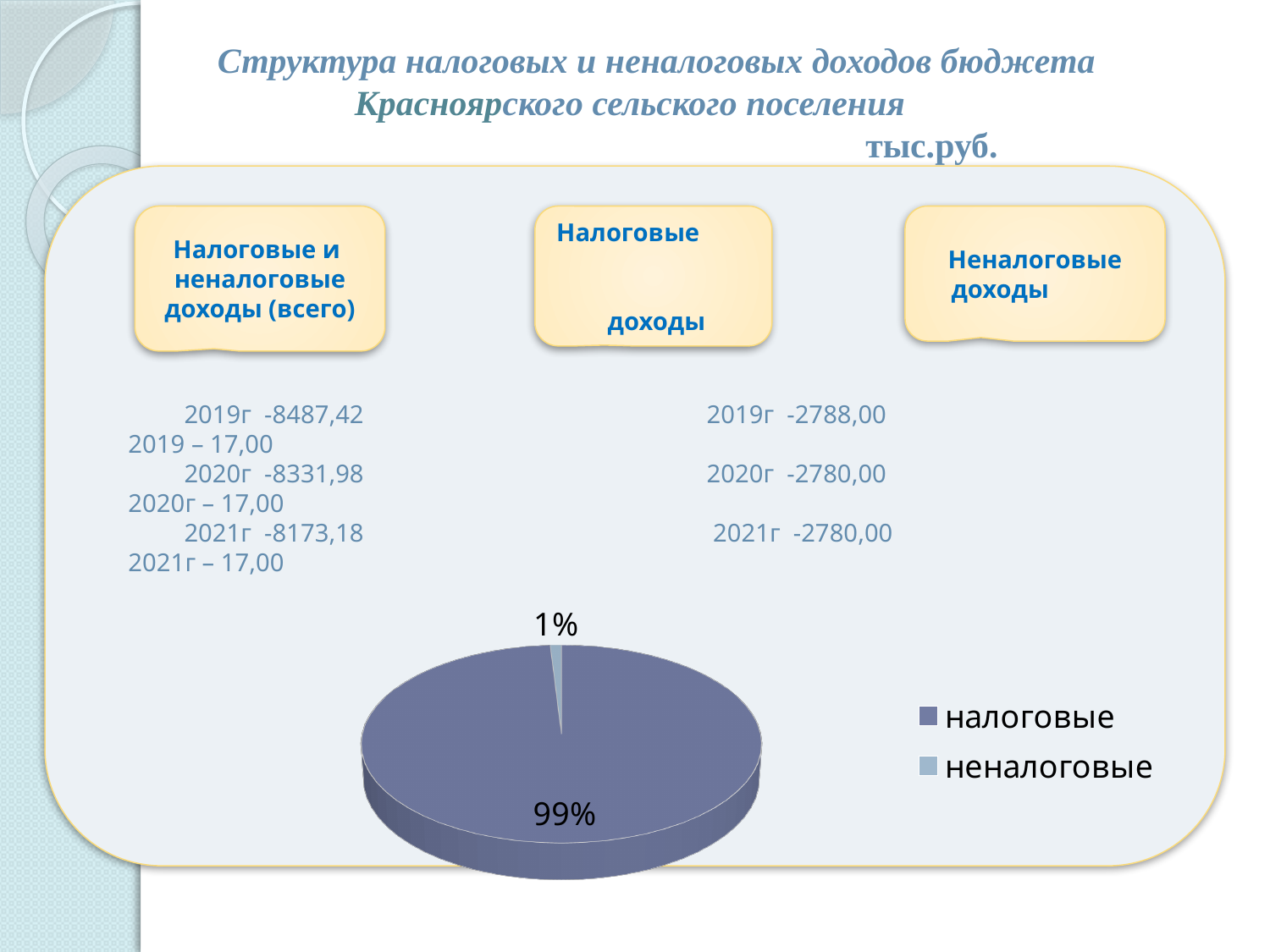
Which legend entry is shown in the light blue-grey colour? неналоговые Which is larger in the pie chart, "налоговые" or "неналоговые"? налоговые What is the value printed on the largest slice of the pie chart? 99% What kind of chart is shown on the slide? Pie chart Which slice of the pie chart is the largest? налоговые What share of the pie does the "неналоговые" slice represent? 1% How many entries does the legend of the pie chart list? 2 What share of the pie does the "налоговые" slice represent? 99% What is the difference in percentage points between the "налоговые" and "неналоговые" slices? 98 Which slice of the pie chart is the smallest? неналоговые How many slices does the pie chart have? 2 Which legend entry is shown in the dark blue-grey colour? налоговые